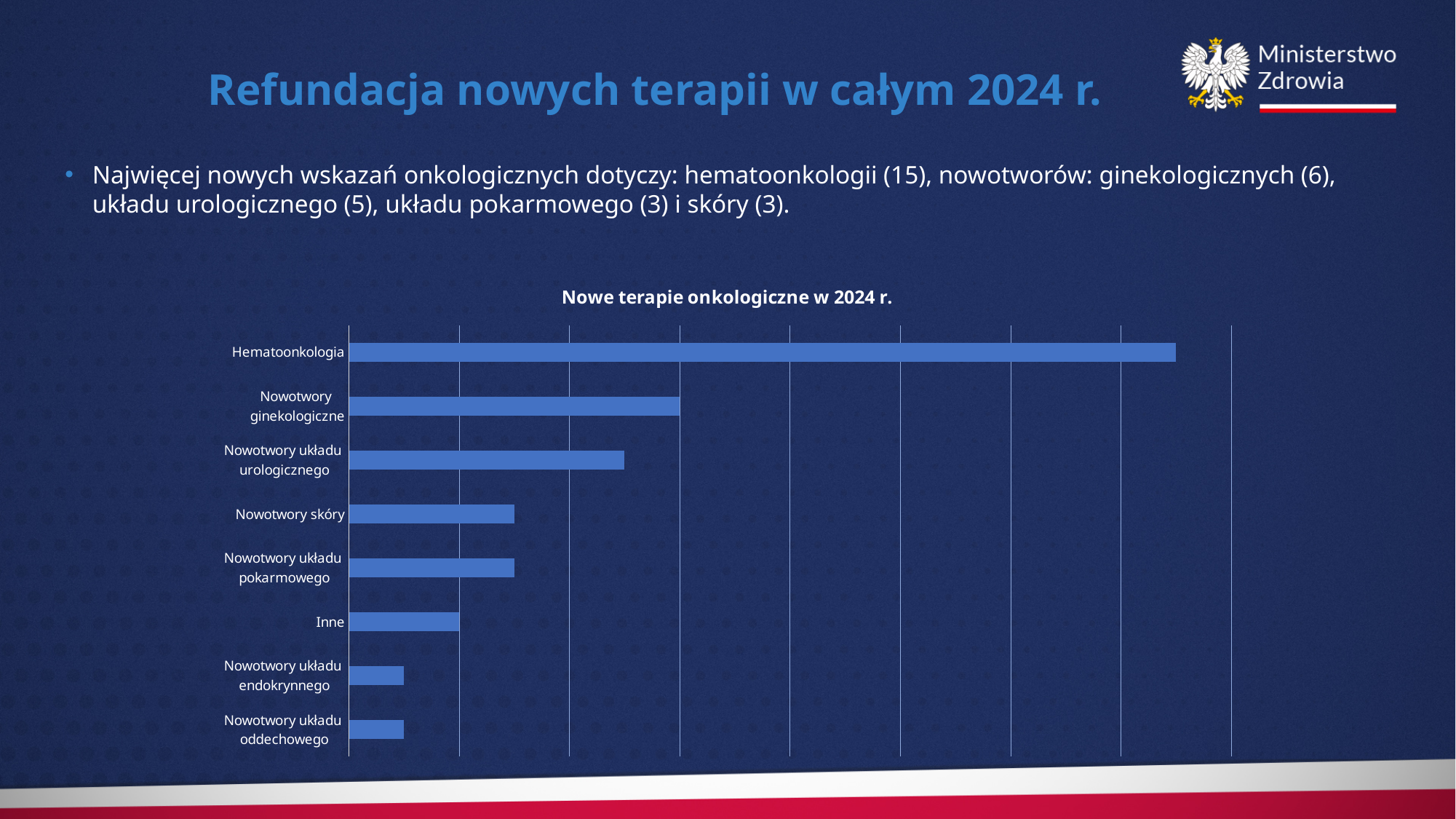
What is the title of the chart? Nowe terapie onkologiczne w 2024 r. Which is larger, the value for Hematoonkologia or the value for Nowotwory ginekologiczne? Hematoonkologia How many categories are shown in the chart? 8 Which category is listed at the top of the chart? Hematoonkologia What kind of chart is shown on the slide? bar chart Which category has the highest value in the chart? Hematoonkologia Which is larger, the value for Nowotwory układu urologicznego or the value for Inne? Nowotwory układu urologicznego Which is larger, the value for Inne or the value for Nowotwory układu endokrynnego? Inne